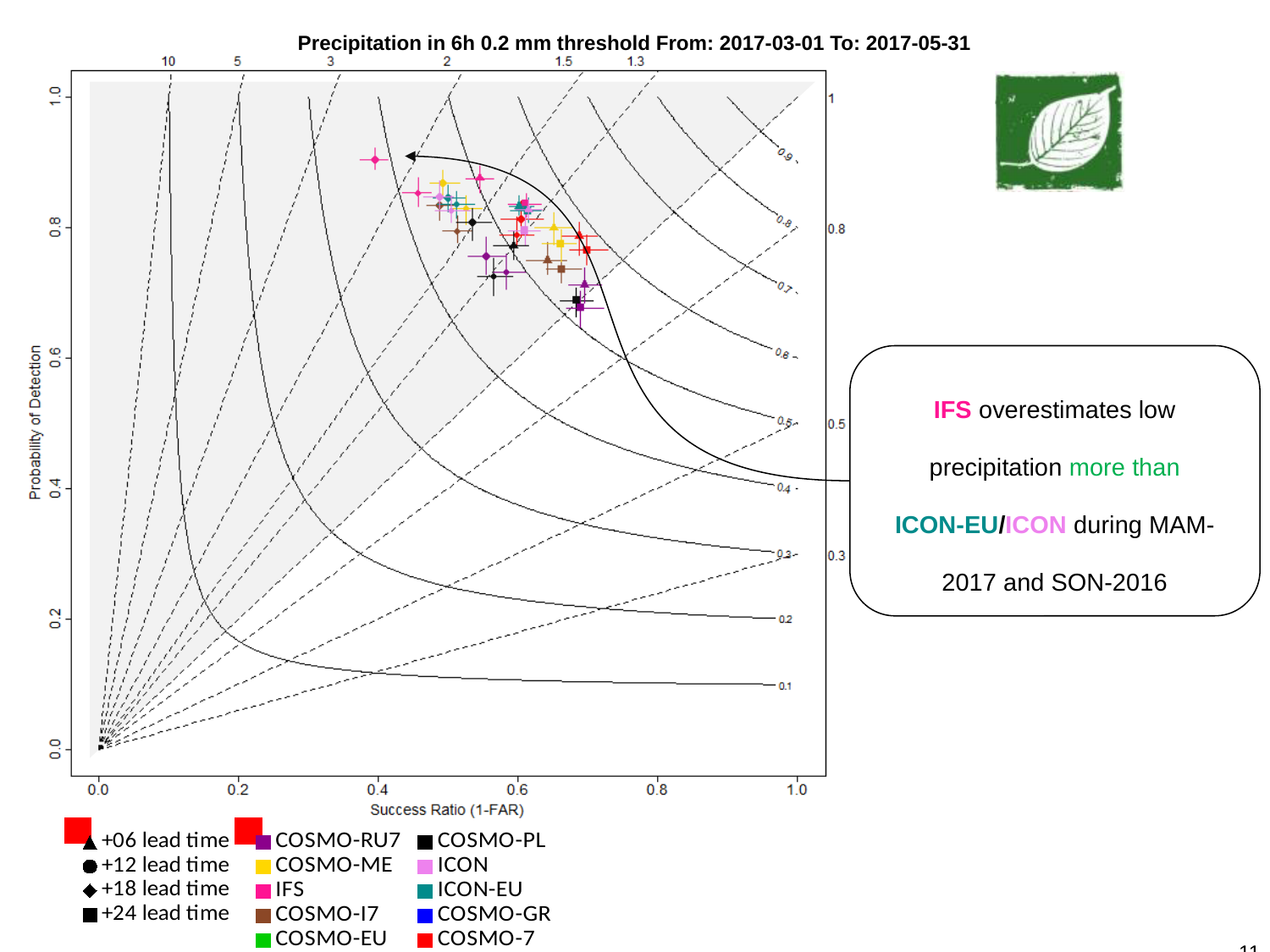
What is the title of the chart? Precipitation in 6h 0.2 mm threshold From: 2017-03-01 To: 2017-05-31 How many lead times are listed in the chart's legend? 4 Which marker shape represents the +24 lead time in the legend? Square Is the Probability of Detection of the highest IFS point greater or less than 0.8? greater What kind of chart is shown on the slide? Scatter plot Which model has the point with the highest Probability of Detection? IFS What is the label of the x axis of the chart? Success Ratio (1-FAR) How many models are listed in the chart's legend? 10 Is the Success Ratio of the highest IFS point greater or less than 0.6? less Are all plotted model points at a Success Ratio greater or less than 0.2? greater